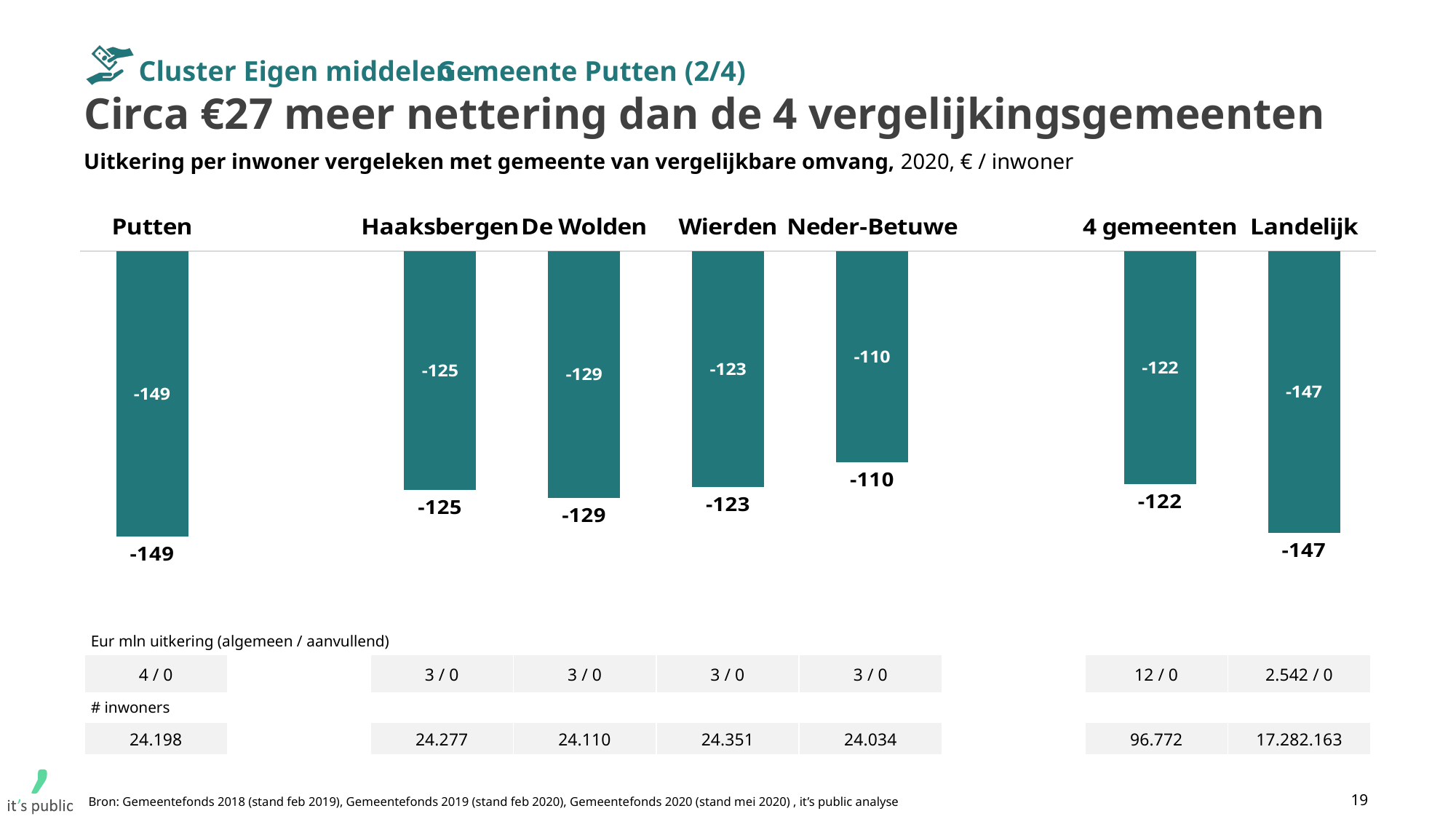
What is the value shown for Putten? -149 What is the value shown for Neder-Betuwe? -110 Which bar is longer (more negative): Wierden or De Wolden? De Wolden What kind of chart is shown on the slide? Bar chart Which category has the most negative value (the longest bar)? Putten What is the difference between the values for Putten and 4 gemeenten? 27 What is the value shown for 4 gemeenten? -122 How many bars are plotted in the chart? 7 What is the difference between the values for Haaksbergen and De Wolden? 4 What is the title of the chart? Uitkering per inwoner vergeleken met gemeente van vergelijkbare omvang, 2020, € / inwoner Which category has the value closest to zero (the shortest bar)? Neder-Betuwe What is the value shown for Landelijk? -147